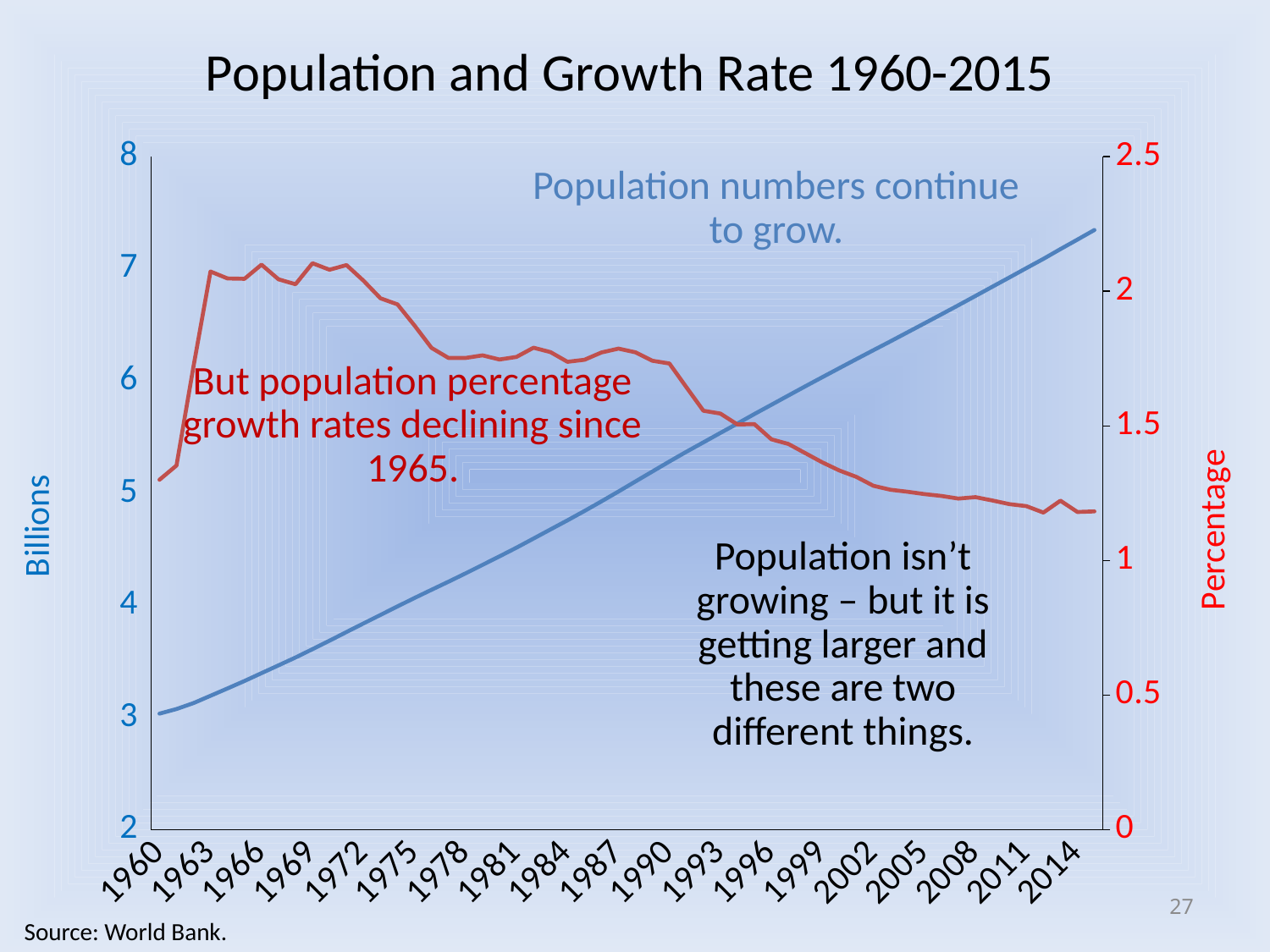
Is the growth rate value for 2014 on the Percentage axis greater or less than 1.5? less What is the label on the left vertical axis of the chart? Billions What kind of chart is shown on the slide? Line chart Which year has the larger population on the blue line, 1960 or 2014? 2014 Is the population value for 1990 on the Billions axis greater or less than 5? greater Is the population value for 2014 on the Billions axis greater or less than 7? greater What is the title of the chart? Population and Growth Rate 1960-2015 Does the population (blue line, Billions axis) rise or fall from 1960 to 2014? Rise Which year has the higher growth rate on the red line, 1969 or 2011? 1969 Does the growth rate (red line, Percentage axis) rise or fall from 1969 to 2014? Fall